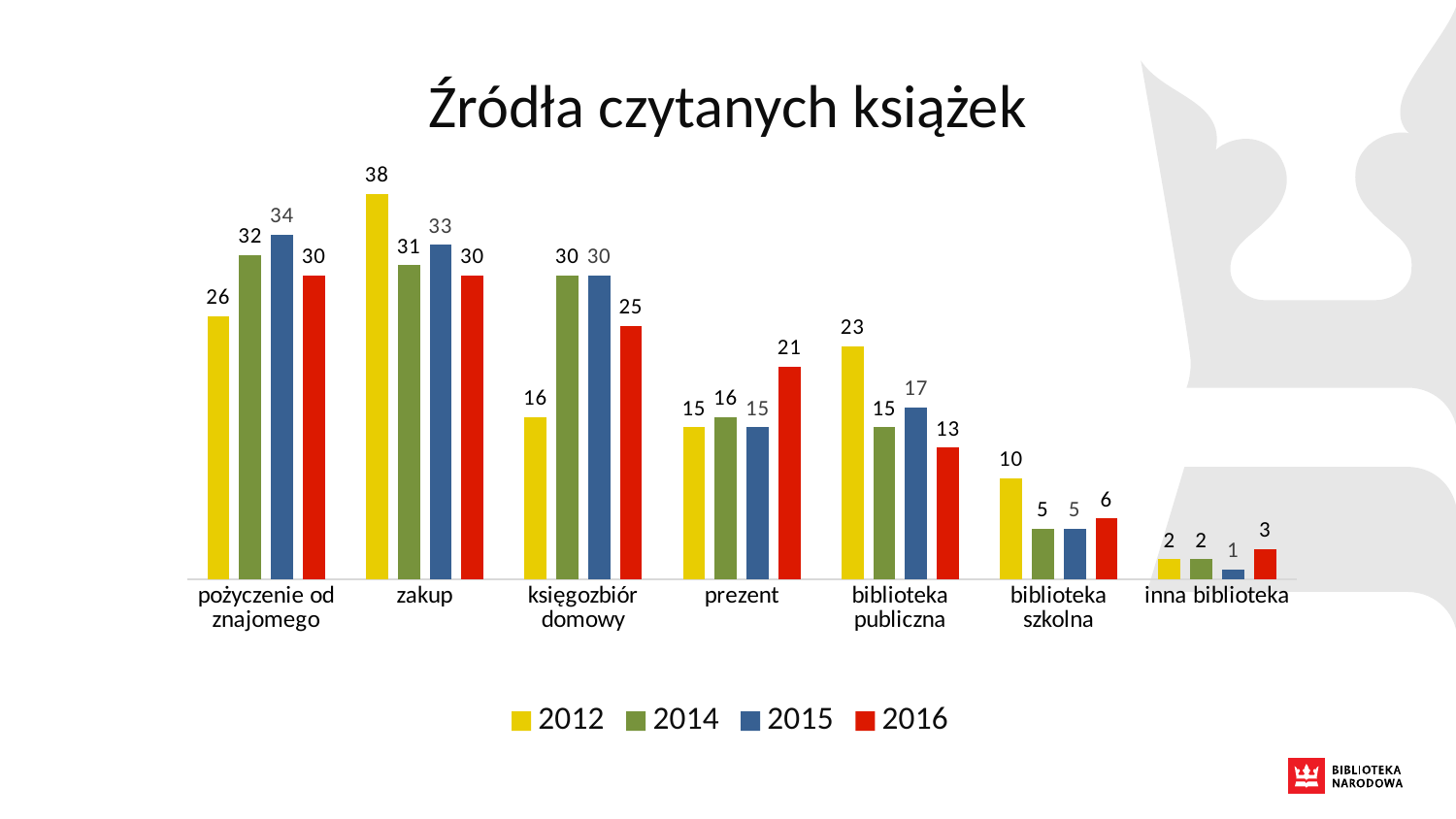
What is the value for 'zakup' in 2012? 38 What is the value for 'prezent' in 2014? 16 Do the values for 'biblioteka szkolna' rise or fall from 2012 to 2016? fall What is the value for 'biblioteka publiczna' in 2016? 13 Which category has the highest value in 2015? pożyczenie od znajomego Which is larger for 'prezent': the 2016 value or the 2012 value? 2016 How many categories are shown on the x axis? 7 How many series does the legend list? 4 Which category has the lowest value in 2016? inna biblioteka What kind of chart is shown on the slide? bar chart What is the title of the chart? Źródła czytanych książek What is the difference between the 2012 and 2016 values for 'biblioteka publiczna'? 10